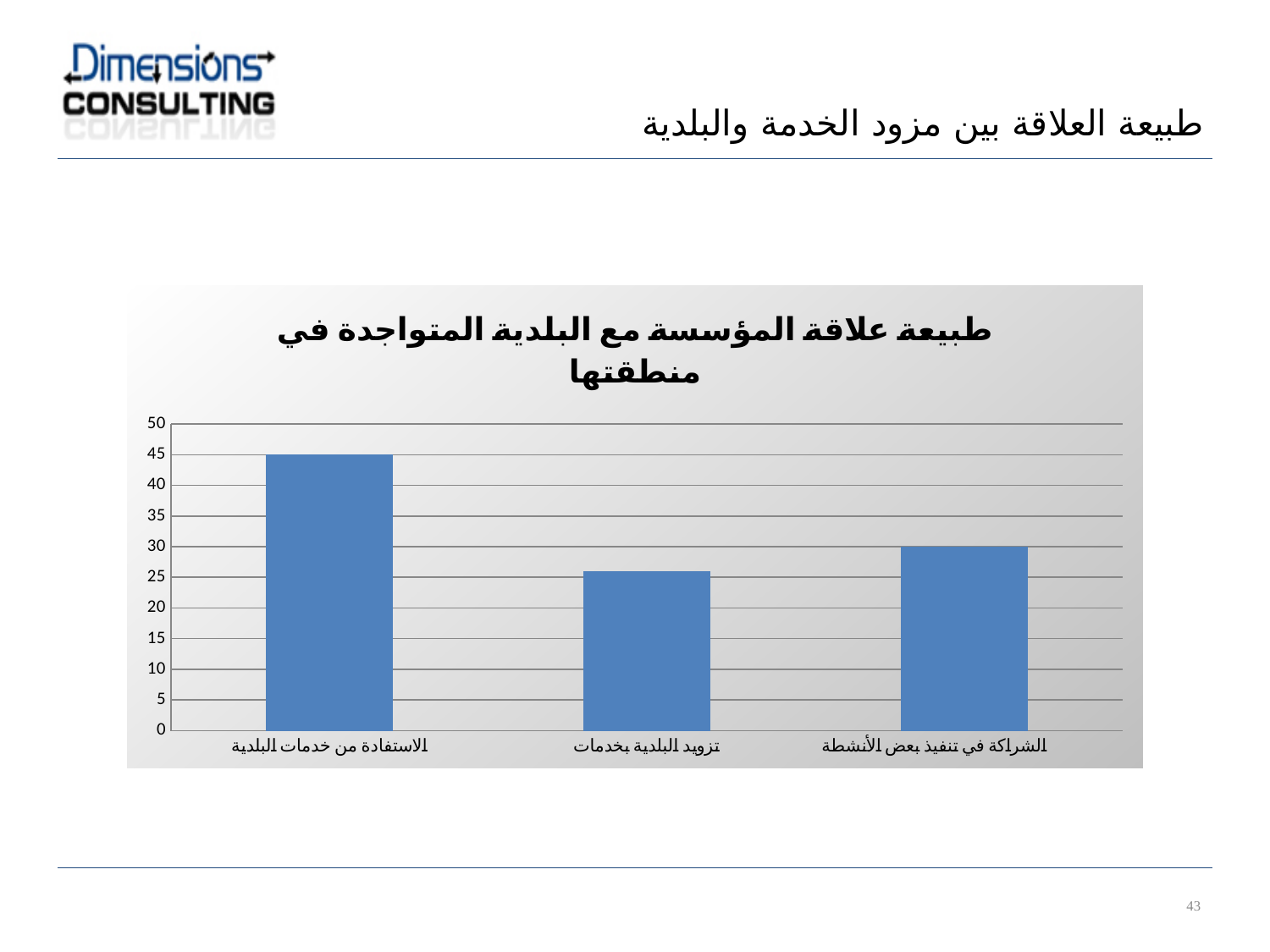
What is the difference between the values for الاستفادة من خدمات البلدية and الشراكة في تنفيذ بعض الأنشطة? 15 Which category has the highest value? الاستفادة من خدمات البلدية How many categories are shown on the x axis of the chart? 3 What type of chart is shown on the slide? bar chart What is the value for الشراكة في تنفيذ بعض الأنشطة? 30 Is the value for تزويد البلدية بخدمات greater or less than 30? less What is the title of the chart? طبيعة علاقة المؤسسة مع البلدية المتواجدة في منطقتها What is the maximum value shown on the vertical axis of the chart? 50 Which category has the lowest value? تزويد البلدية بخدمات Which is larger, the value for تزويد البلدية بخدمات or the value for الشراكة في تنفيذ بعض الأنشطة? الشراكة في تنفيذ بعض الأنشطة What is the value for الاستفادة من خدمات البلدية? 45